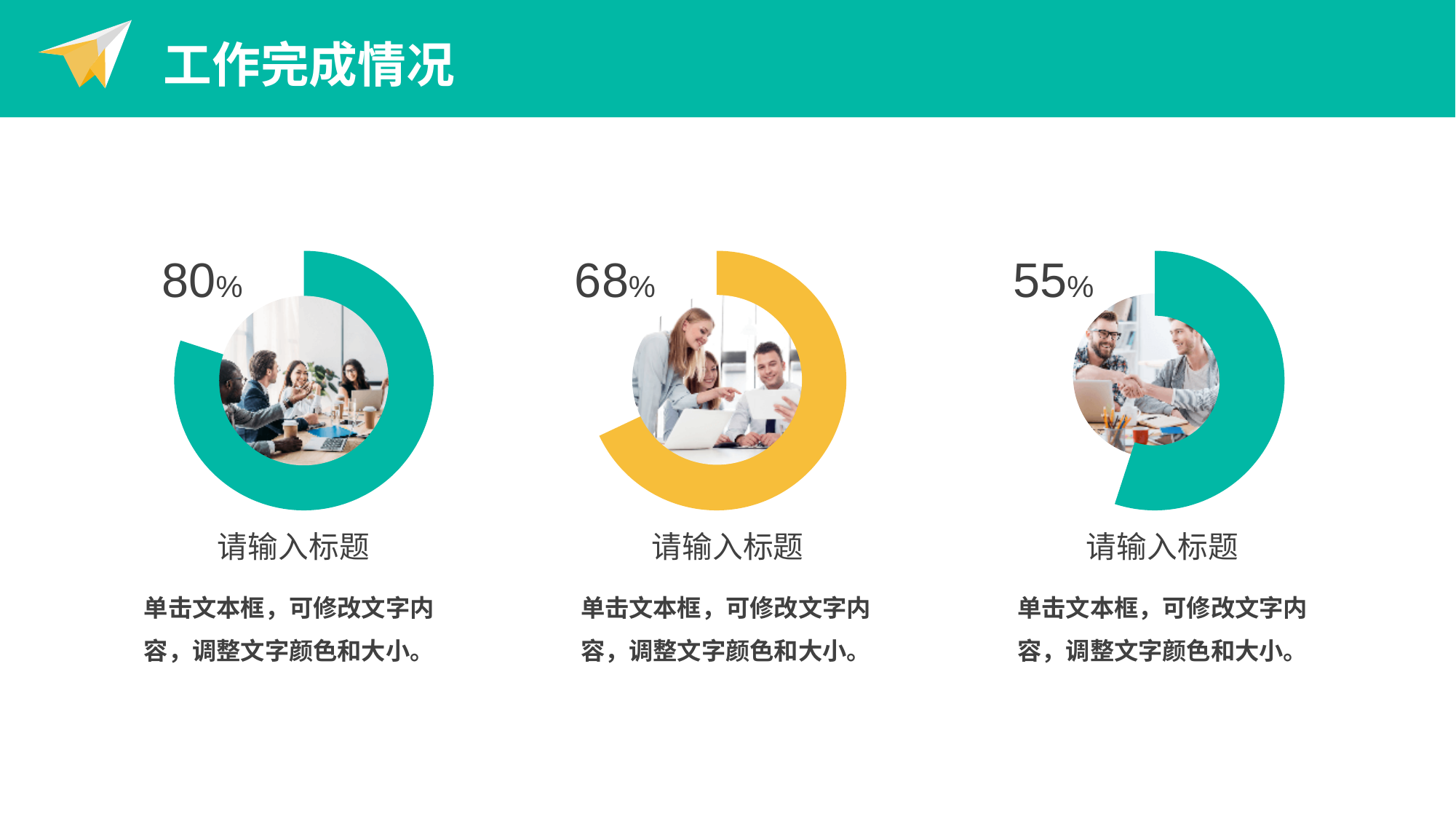
What is the difference between the value on the left chart and the value on the right chart? 25% Which of the three charts shows the highest percentage? The left chart (80%) What colour is the ring of the middle chart? Yellow How many ring charts are shown on the slide? 3 What value is shown on the right chart? 55% What value is shown on the middle chart? 68% Which of the three charts shows the lowest percentage? The right chart (55%) What is the difference between the value on the middle chart and the value on the right chart? 13% What is the difference between the value on the left chart and the value on the middle chart? 12% What value is shown on the left chart? 80% What kind of chart is used to show each percentage on the slide? Donut (ring) chart Which is larger, the value on the middle chart or the value on the right chart? The middle chart (68%)